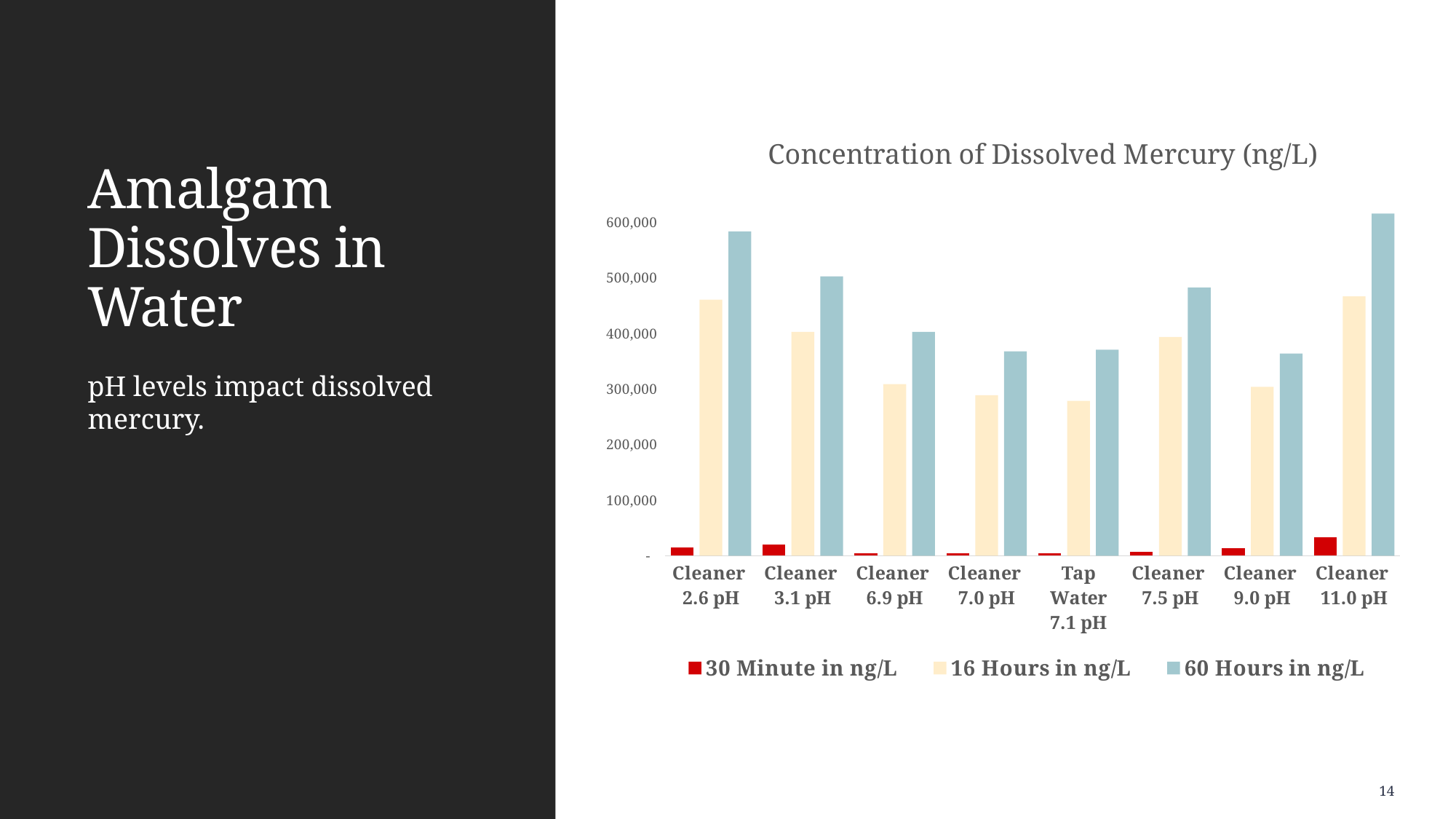
Which colour represents the 30 Minute in ng/L series in the legend? Red What kind of chart is shown on the slide? Bar chart Which category has the highest value for the 60 Hours in ng/L series? Cleaner 11.0 pH Is the 30 Minute in ng/L value for Cleaner 11.0 pH greater or less than 100,000? less How many series does the legend list? 3 Is the 16 Hours in ng/L value for Cleaner 7.0 pH greater or less than 300,000? less What is the title of the chart? Concentration of Dissolved Mercury (ng/L) How many categories are shown on the x axis? 8 Which category has the highest value for the 30 Minute in ng/L series? Cleaner 11.0 pH Is the 60 Hours in ng/L value for Cleaner 2.6 pH greater or less than 500,000? greater For the 16 Hours in ng/L series, which is larger: Cleaner 2.6 pH or Cleaner 9.0 pH? Cleaner 2.6 pH